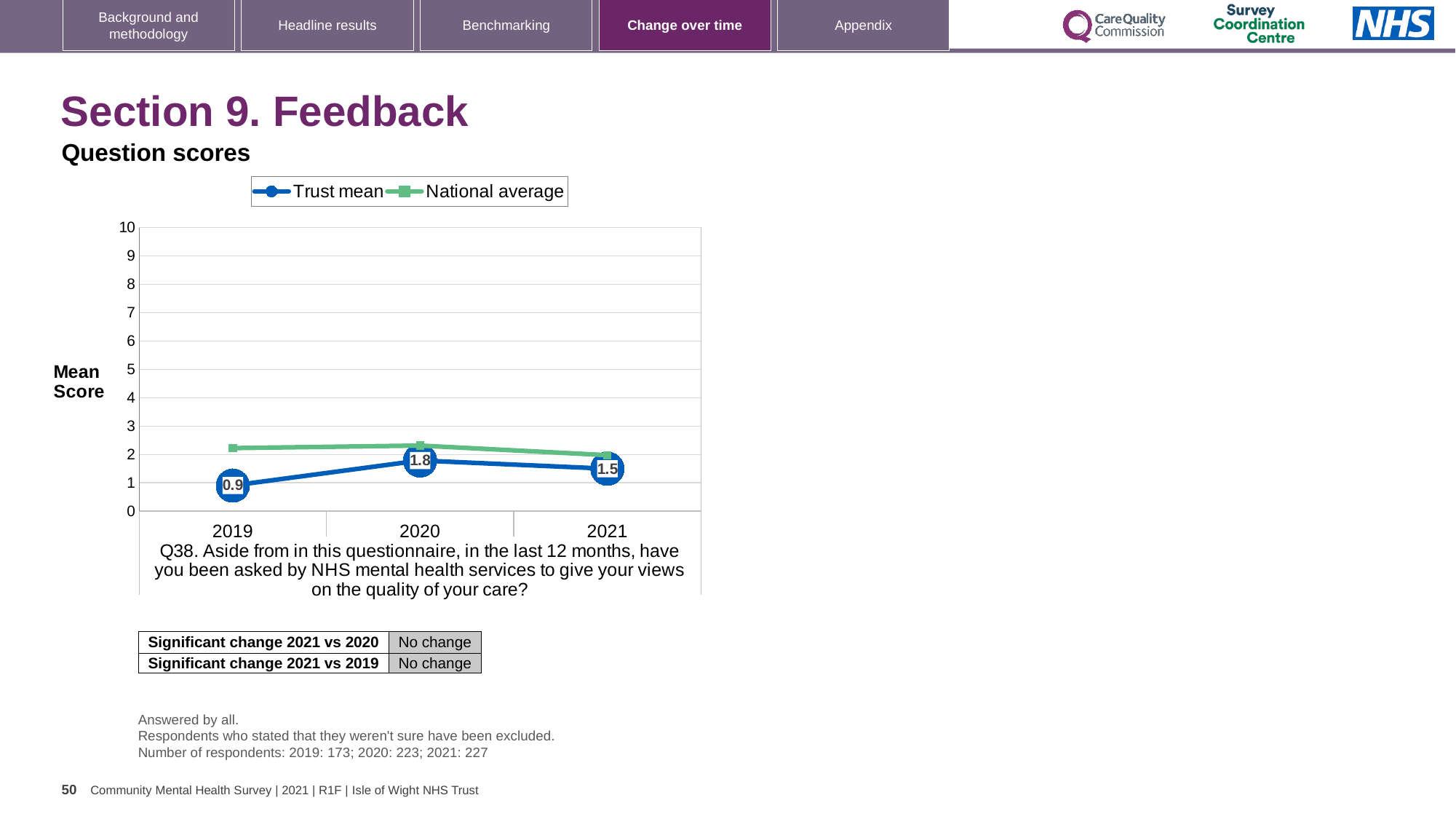
What is the Trust mean score for 2021? 1.5 By how much did the Trust mean score increase from 2019 to 2020? 0.9 Is the National average for 2020 greater or less than 3? less In 2019, which is higher: the Trust mean or the National average? National average What is the Trust mean score for 2019? 0.9 What is the Trust mean score for 2020? 1.8 In which year is the Trust mean score lowest? 2019 How many series does the legend list? 2 What is the difference between the Trust mean score in 2020 and in 2021? 0.3 How many years are plotted on the x axis? 3 In which year is the Trust mean score highest? 2020 What kind of chart is shown on the slide? Line chart